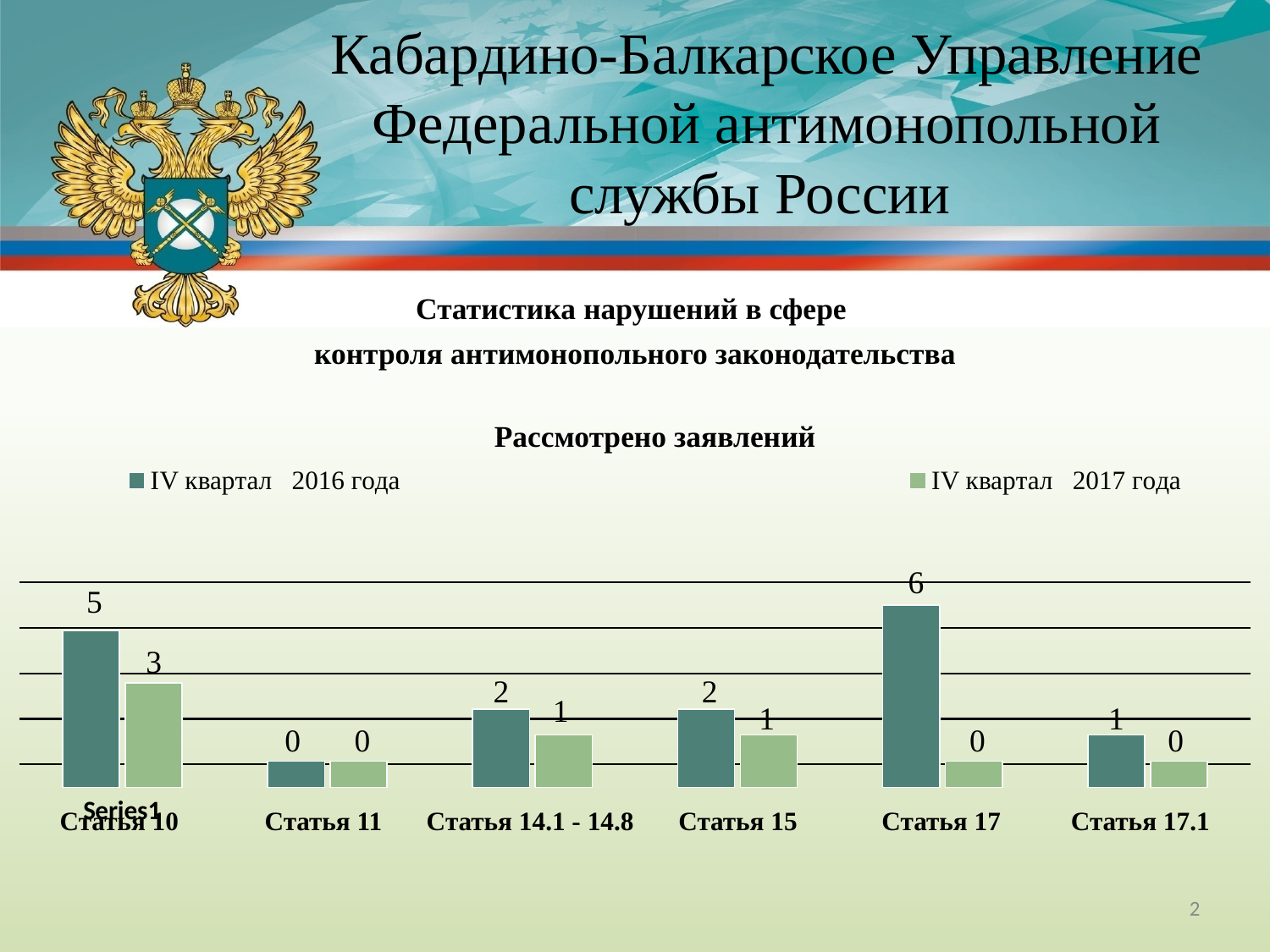
What is the value for Статья 10 in IV квартал 2016 года? 5 What is the difference between the IV квартал 2016 года and IV квартал 2017 года values for Статья 17? 6 Which category has the highest value for IV квартал 2016 года? Статья 17 What is the title of the chart? Рассмотрено заявлений What type of chart is shown on the slide? bar chart How many categories (статьи) are shown on the x axis? 6 Which category has the highest value for IV квартал 2017 года? Статья 10 Which is larger for Статья 15: the value for IV квартал 2016 года or IV квартал 2017 года? IV квартал 2016 года What is the value for Статья 17 in IV квартал 2016 года? 6 How many series does the legend list? 2 What is the value for Статья 10 in IV квартал 2017 года? 3 What is the value for Статья 14.1 - 14.8 in IV квартал 2017 года? 1